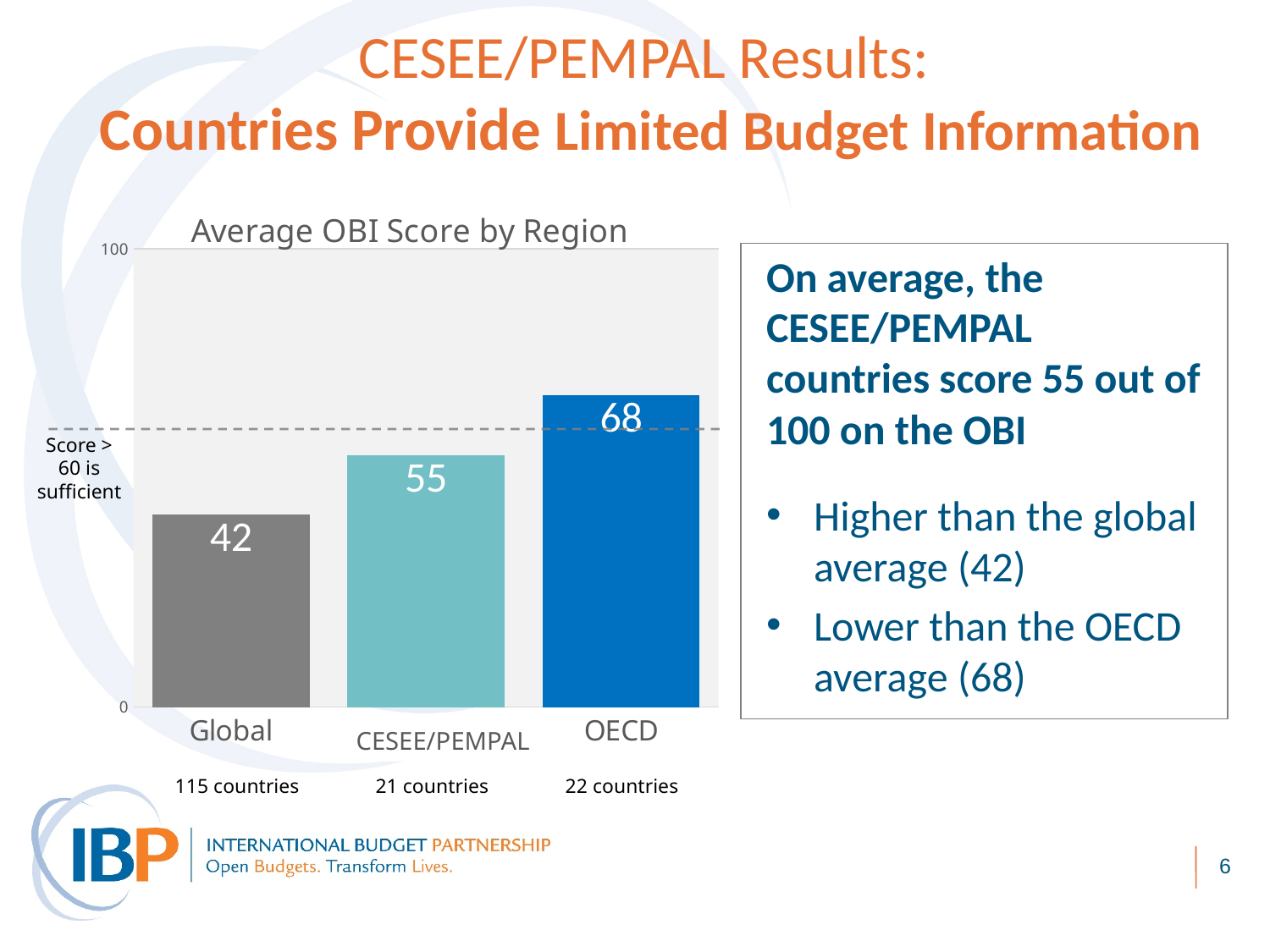
What is the difference between the CESEE/PEMPAL and Global average OBI scores? 13 What is the average OBI score for OECD? 68 How many countries are included in the CESEE/PEMPAL bar? 21 countries How many regions are shown in the chart? 3 What kind of chart is shown on the slide? Bar chart Which has a higher average OBI score, Global or CESEE/PEMPAL? CESEE/PEMPAL What is the difference between the OECD and CESEE/PEMPAL average OBI scores? 13 Which region has the highest average OBI score? OECD What is the title of the chart? Average OBI Score by Region Which region has the lowest average OBI score? Global What is the average OBI score for CESEE/PEMPAL? 55 What is the average OBI score for the Global category? 42